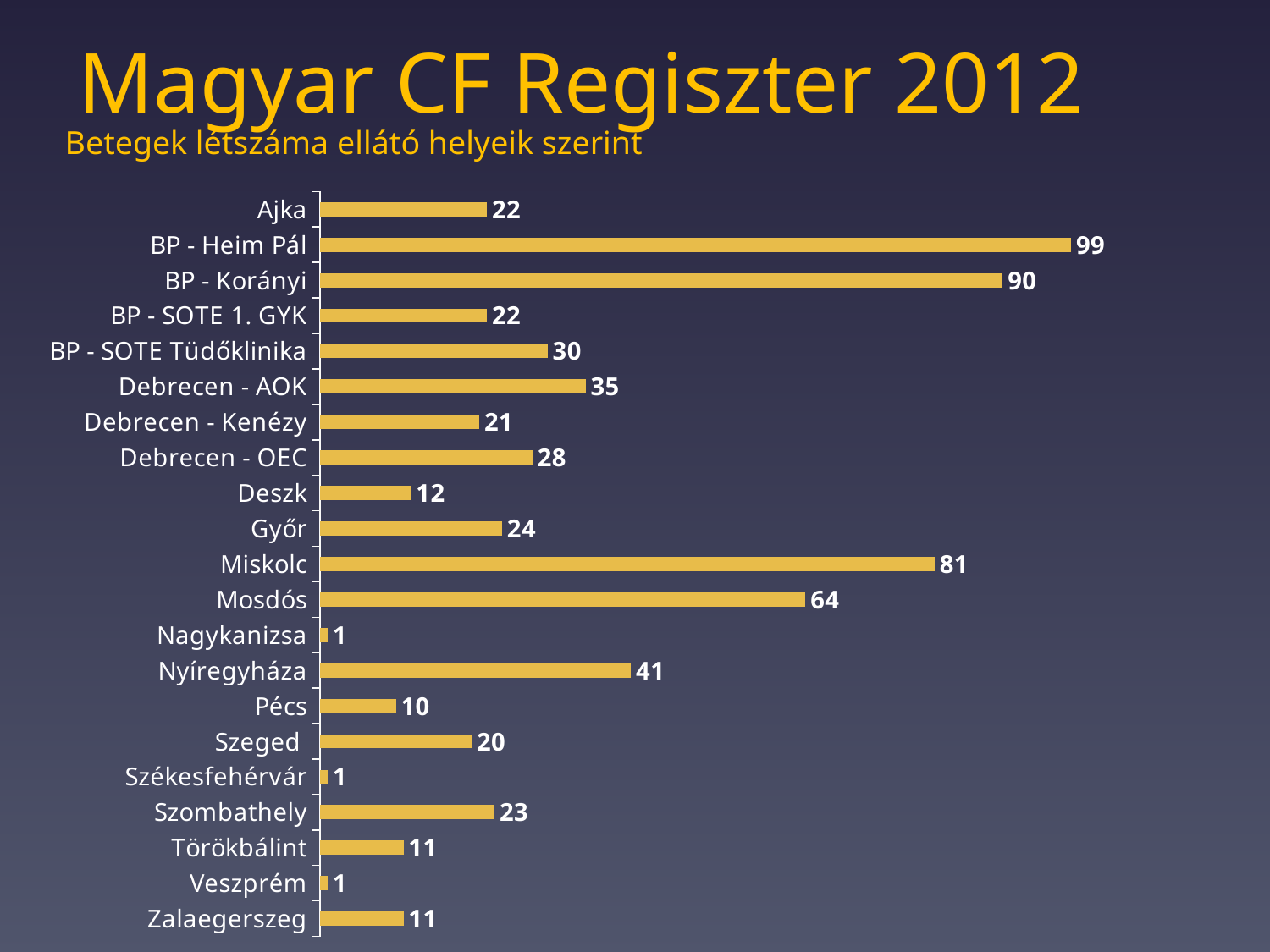
What is the value for Miskolc? 81 Which is larger, the value for Szombathely or the value for Szeged? Szombathely How many categories are shown on the chart? 21 What is the value for Nyíregyháza? 41 Which is larger, the value for Győr or the value for Pécs? Győr What kind of chart is shown on the slide? Bar chart What is the difference between the values for Debrecen - AOK and Deszk? 23 Which category has the highest value? BP - Heim Pál What is the difference between the values for BP - Korányi and Mosdós? 26 How many categories have a value of 1? 3 What is the value for Debrecen - OEC? 28 What is the value for BP - Heim Pál? 99